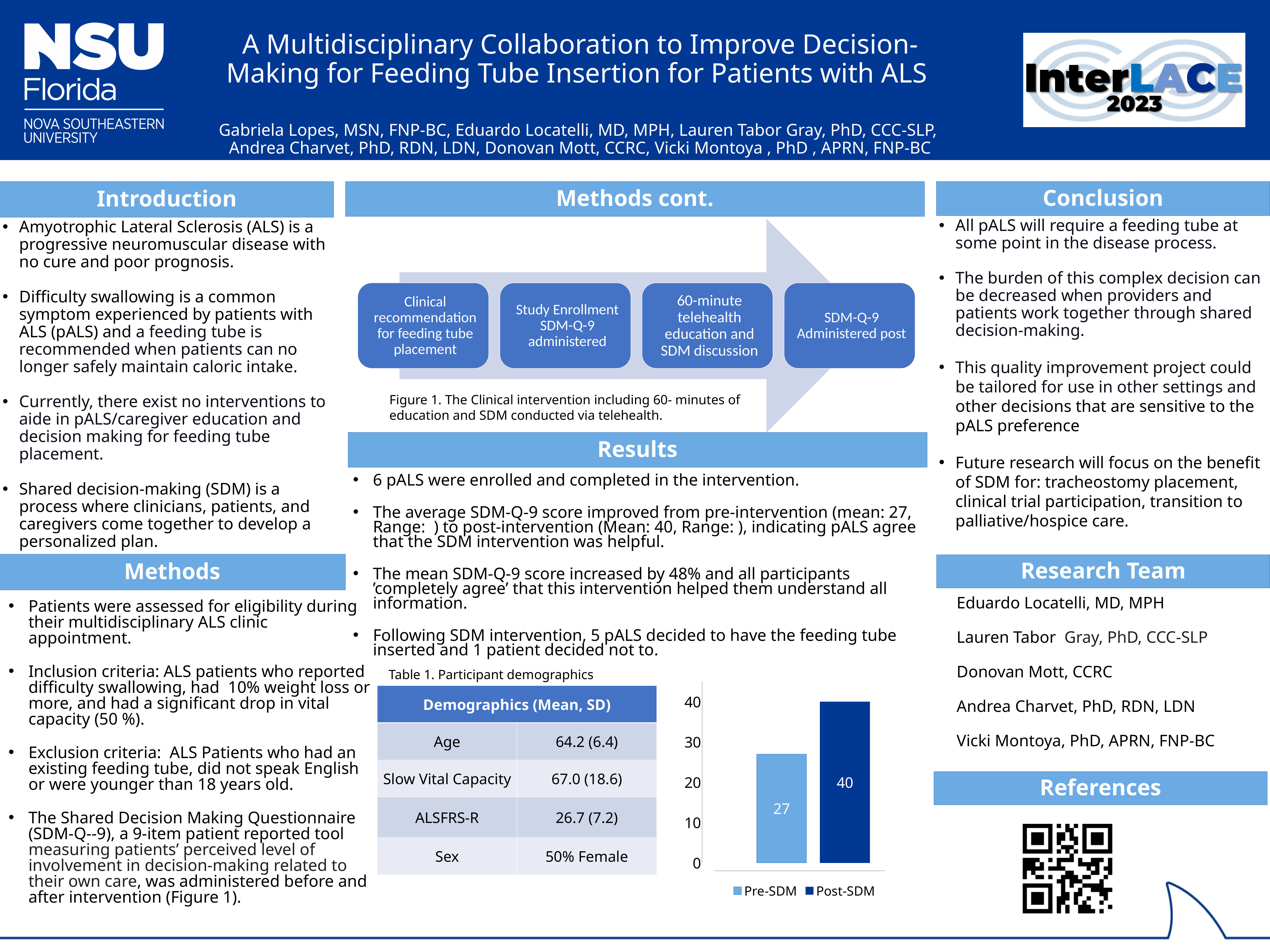
What is the difference between the Post-SDM and Pre-SDM values in the bar chart? 13 What type of chart is shown in the Results section? bar chart Which series has the lower value in the bar chart? Pre-SDM Is the value for Post-SDM greater or less than 30 in the bar chart? greater Which series has the higher value in the bar chart, Pre-SDM or Post-SDM? Post-SDM Is the value for Pre-SDM greater or less than 30 in the bar chart? less Is the Pre-SDM value larger or smaller than the Post-SDM value in the bar chart? smaller What is the value of the Pre-SDM bar in the bar chart? 27 How many bars are plotted in the bar chart? 2 How many series does the legend of the bar chart list? 2 What are the two legend entries of the bar chart? Pre-SDM and Post-SDM What is the value of the Post-SDM bar in the bar chart? 40